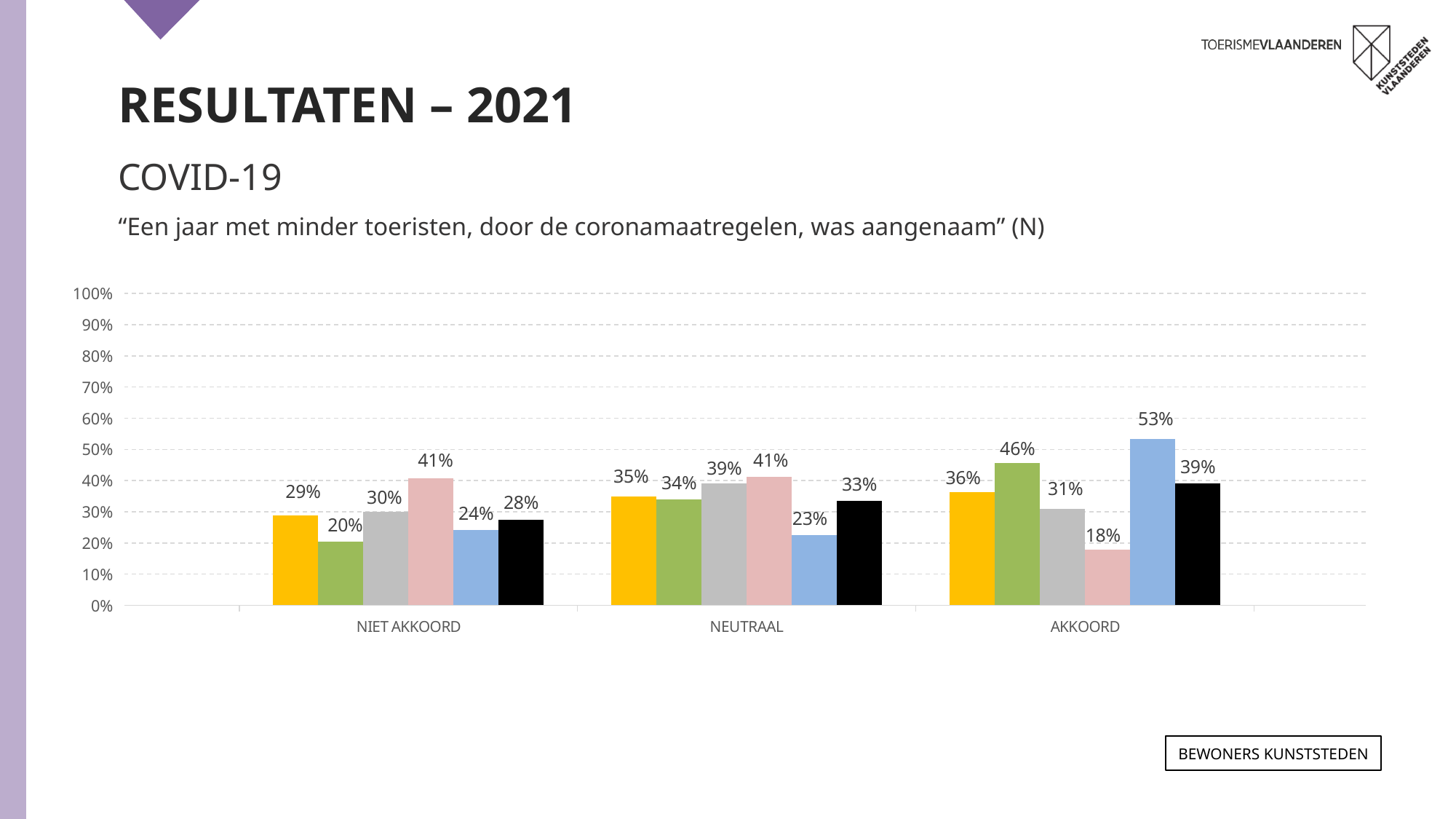
What is the value of the black bar in the NEUTRAAL category? 33% What is the highest value shown on the y axis of the chart? 100% Which bar in the AKKOORD category has the lowest value? the pink bar (18%) How many bars are plotted in each category of the chart? 6 What is the value of the blue bar in the AKKOORD category? 53% What is the difference between the blue bar in AKKOORD (53%) and the blue bar in NIET AKKOORD (24%)? 29 percentage points What type of chart is shown on the slide? bar chart Which is larger: the yellow bar in NEUTRAAL or the yellow bar in NIET AKKOORD? the yellow bar in NEUTRAAL (35%) How many categories are shown on the x axis of the chart? 3 Which bar in the NEUTRAAL category has the highest value? the pink bar (41%) What is the value of the green bar in the NIET AKKOORD category? 20% What is the value of the pink bar in the NIET AKKOORD category? 41%